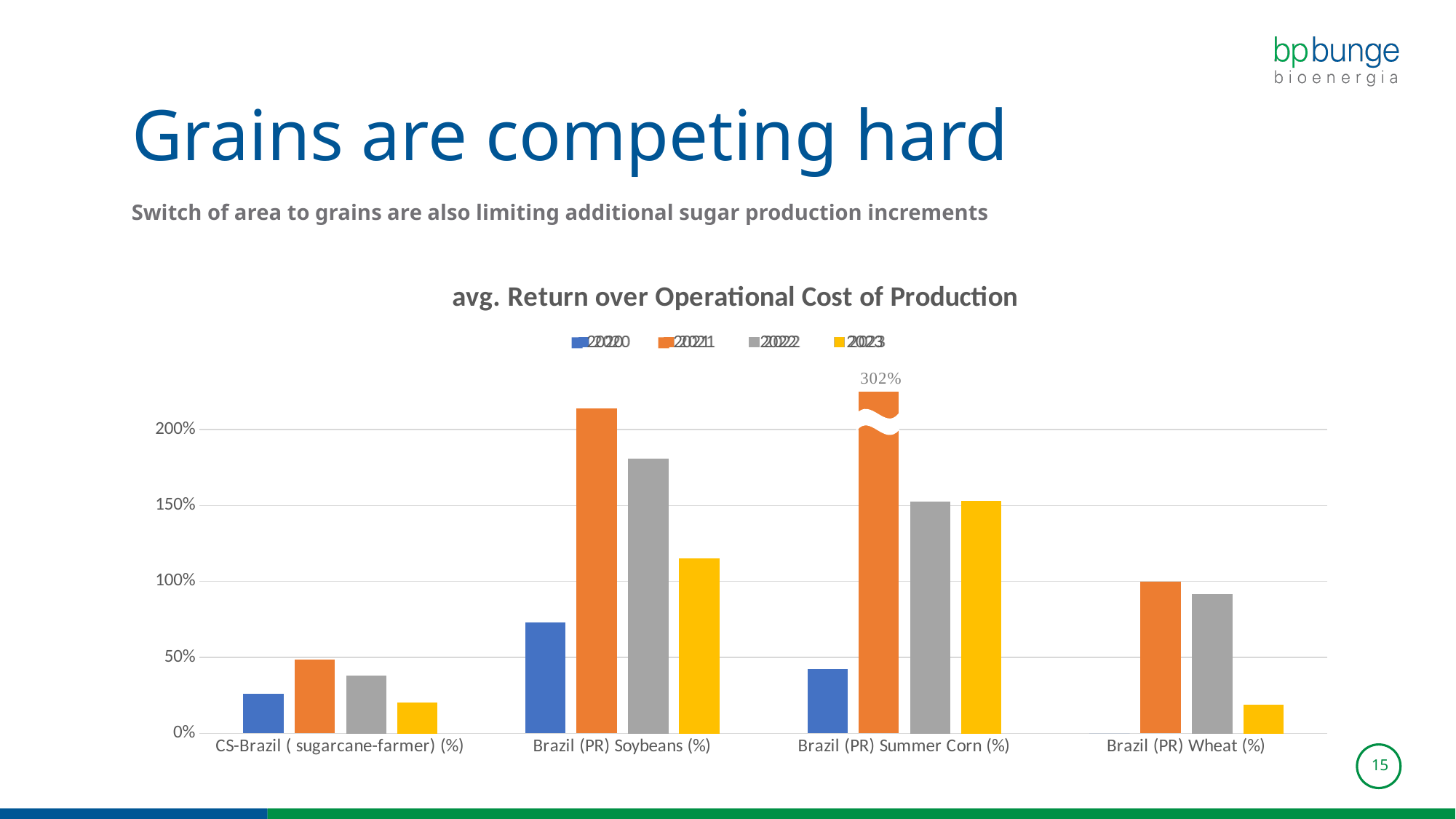
Is the yellow bar for CS-Brazil ( sugarcane-farmer) (%) greater or less than 50%? less What is the title of the chart? avg. Return over Operational Cost of Production Which is larger: the blue bar for Brazil (PR) Soybeans (%) or the blue bar for Brazil (PR) Summer Corn (%)? Brazil (PR) Soybeans (%) How many categories are shown on the x axis of the chart? 4 Which category has the lowest bars overall in the chart? CS-Brazil ( sugarcane-farmer) (%) Which category contains the tallest bar in the chart? Brazil (PR) Summer Corn (%) What value is printed on the orange bar for Brazil (PR) Summer Corn (%)? 302% What kind of chart is shown on the slide? bar chart How many series does the legend of the chart list? 4 Is the yellow bar for Brazil (PR) Soybeans (%) greater or less than 100%? greater Is the orange bar for Brazil (PR) Soybeans (%) greater or less than 200%? greater